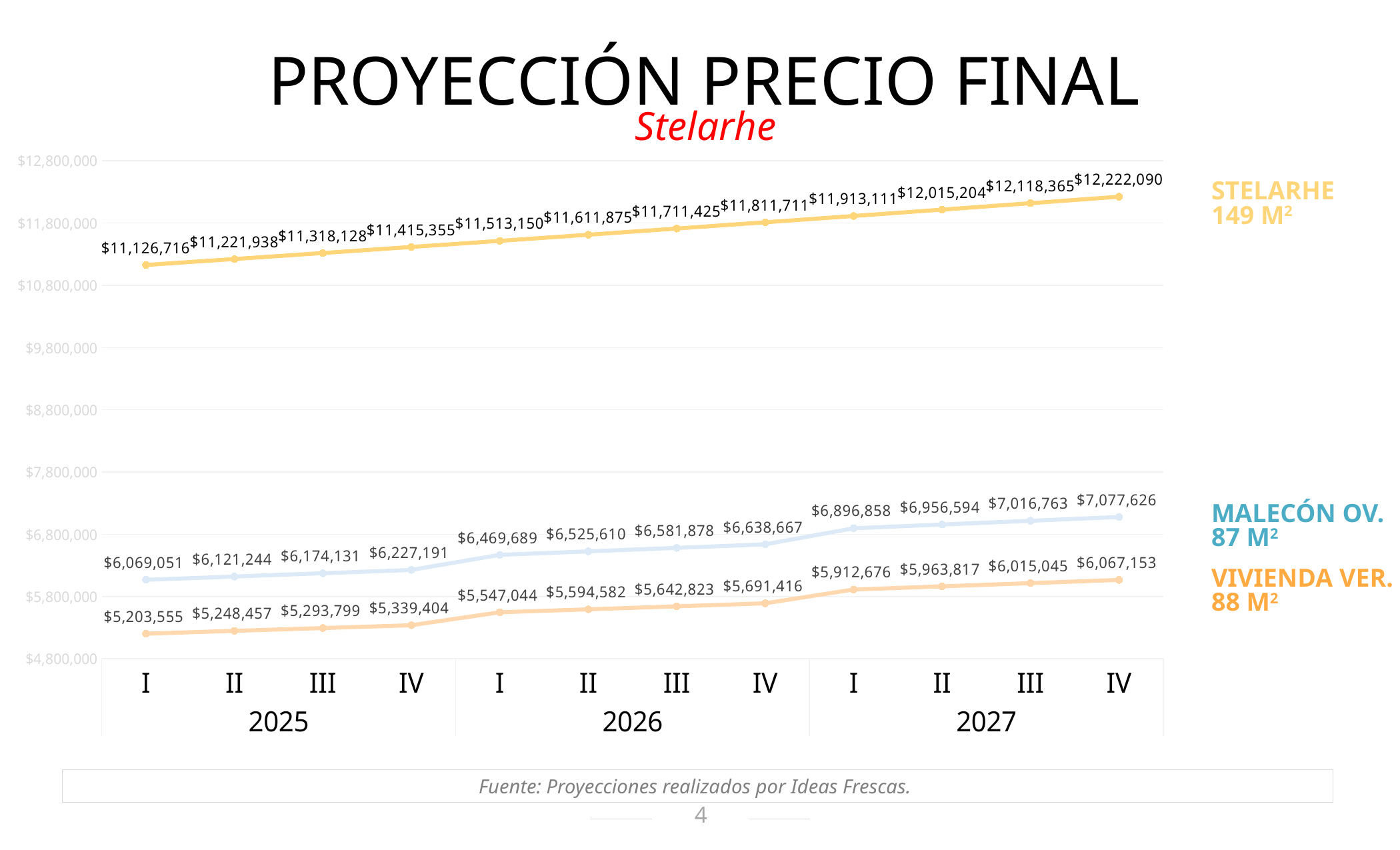
What is the highest value shown for the STELARHE 149 M² line? $12,222,090 What is the lowest value shown for the VIVIENDA VER. 88 M² line? $5,203,555 How many series does the chart show? 3 In quarter II of 2026, which is higher: MALECÓN OV. 87 M² or VIVIENDA VER. 88 M²? MALECÓN OV. 87 M² What is the projected price for STELARHE 149 M² in quarter I of 2025? $11,126,716 By how much does the STELARHE 149 M² price increase from quarter I of 2025 to quarter IV of 2027? $1,095,374 How many quarterly data points does each line have? 12 Do the projected prices rise or fall from 2025 to 2027? Rise What type of chart is shown on the slide? Line chart In quarter IV of 2027, what is the difference between the MALECÓN OV. 87 M² price and the VIVIENDA VER. 88 M² price? $1,010,473 What is the projected price for MALECÓN OV. 87 M² in quarter IV of 2027? $7,077,626 What is the projected price for VIVIENDA VER. 88 M² in quarter I of 2026? $5,547,044